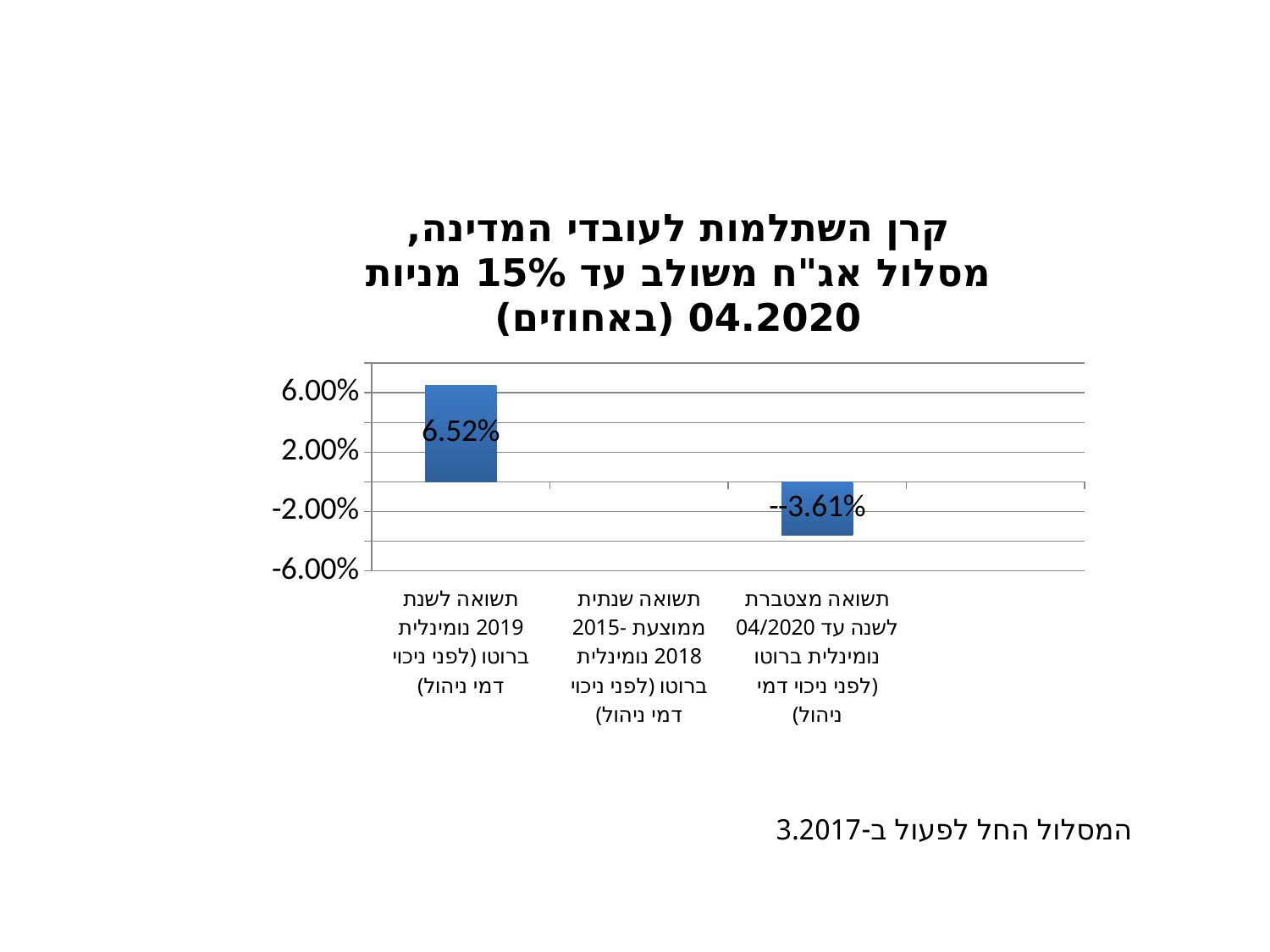
Which category has the lowest plotted value? תשואה מצטברת לשנה עד 04/2020 נומינלית ברוטו (לפני ניכוי דמי ניהול) What is the value for the cumulative return for the year to 04/2020 (תשואה מצטברת לשנה עד 04/2020)? -3.61% What is the difference between the 2019 return (6.52%) and the cumulative return to 04/2020 (-3.61%)? 10.13% Is the value for the cumulative return to 04/2020 greater or less than -2.00%? less Which category has the highest value? תשואה לשנת 2019 נומינלית ברוטו (לפני ניכוי דמי ניהול) What kind of chart is shown on the slide? Bar chart How many categories are shown on the x axis? 3 Is the value for the 2019 return greater or less than 6.00%? greater Which category on the x axis has no bar plotted? תשואה שנתית ממוצעת 2015-2018 נומינלית ברוטו (לפני ניכוי דמי ניהול) Which is larger: the 2019 return or the cumulative return to 04/2020? The 2019 return How many bars are actually plotted on the chart? 2 What is the value for the 2019 return (תשואה לשנת 2019 נומינלית ברוטו)? 6.52%